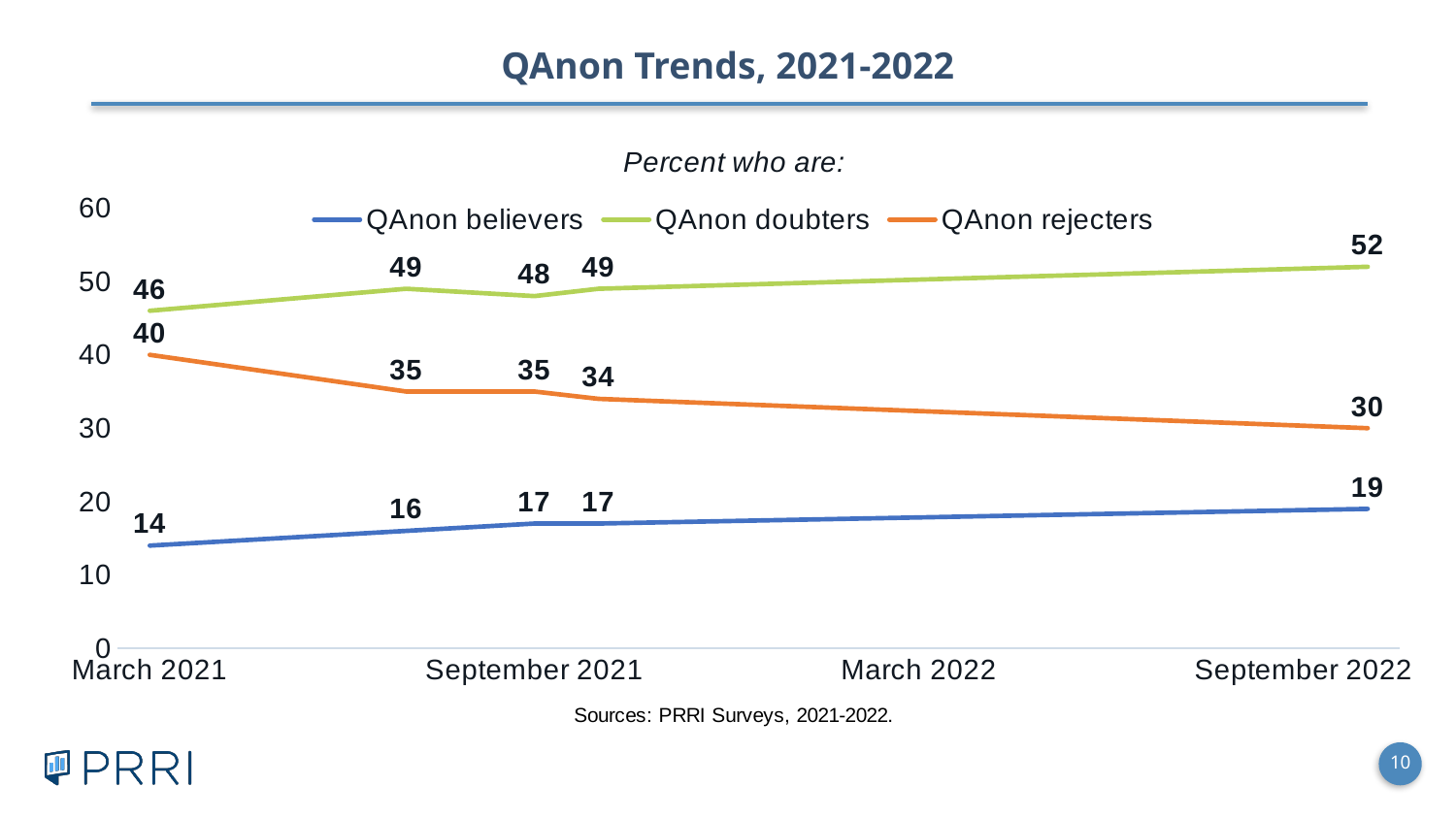
Does the share of QAnon rejecters rise or fall over the period shown? fall By how many points did the share of QAnon rejecters fall from March 2021 to September 2022? 10 Which group had the highest share in September 2022? QAnon doubters What percentage were QAnon believers in March 2021? 14 What percentage were QAnon rejecters in September 2022? 30 By how many points did the share of QAnon doubters change from March 2021 to September 2022? 6 What percentage were QAnon rejecters in March 2021? 40 How many series does the legend list? 3 Does the share of QAnon believers rise or fall from March 2021 to September 2022? rise Which group had the lowest share in March 2021? QAnon believers In March 2021, which was larger: the share of QAnon doubters or QAnon rejecters? QAnon doubters What percentage were QAnon doubters in September 2022? 52